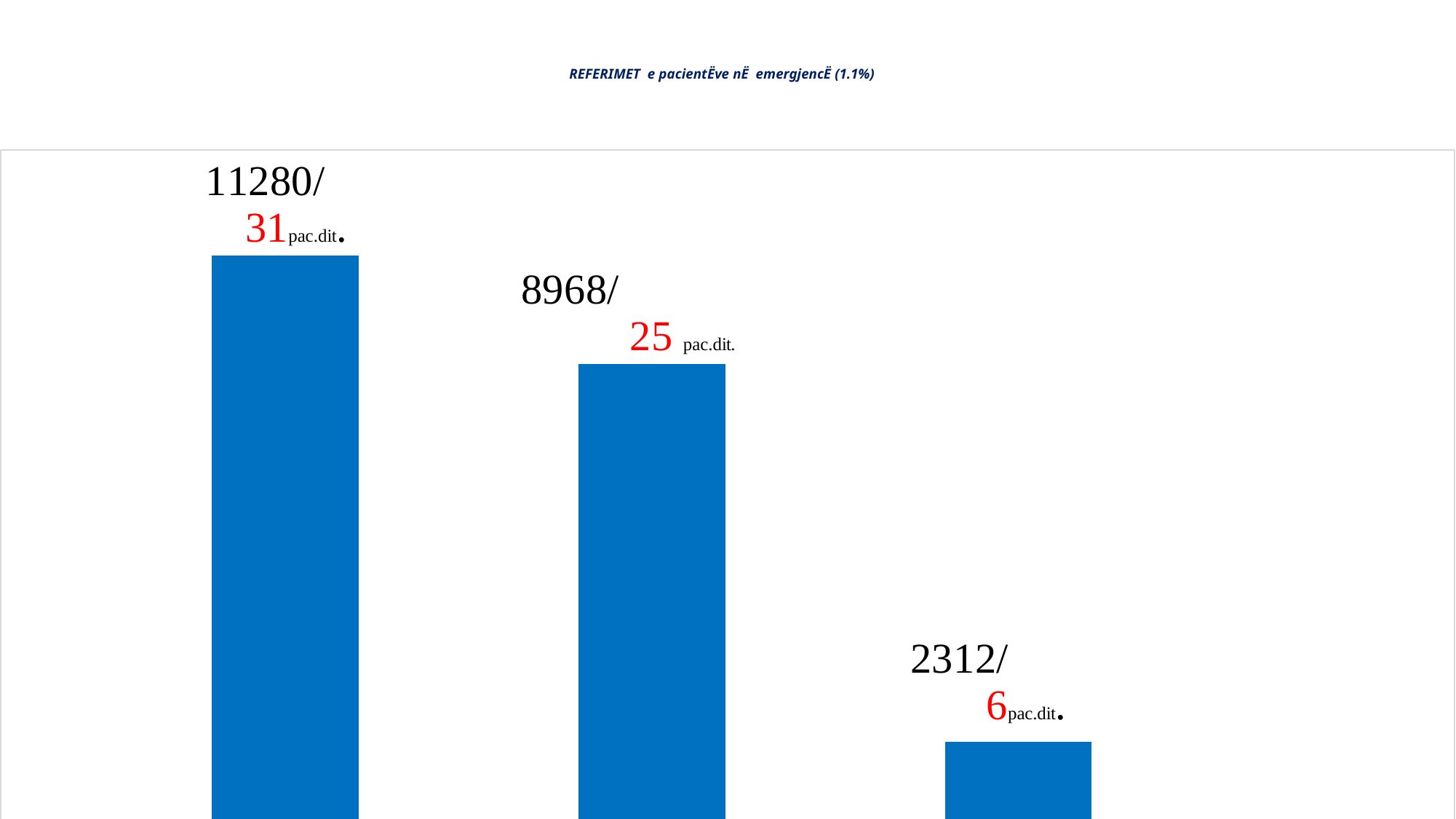
What is the difference between the total values of the leftmost bar and the middle bar? 2312 How many bars does the chart show? 3 What is the total value labelled above the rightmost bar? 2312 What is the total value labelled above the leftmost bar? 11280 Which bar has the lowest value? the rightmost bar (2312) Which bar has the highest value? the leftmost bar (11280) What is the title of the chart? REFERIMET e pacientËve nË emergjencË (1.1%) How many patients per day (pac.dit.) are labelled for the leftmost bar? 31 How many patients per day (pac.dit.) are labelled for the middle bar? 25 What kind of chart is shown on the slide? bar chart How many patients per day (pac.dit.) are labelled for the rightmost bar? 6 What is the total value labelled above the middle bar? 8968